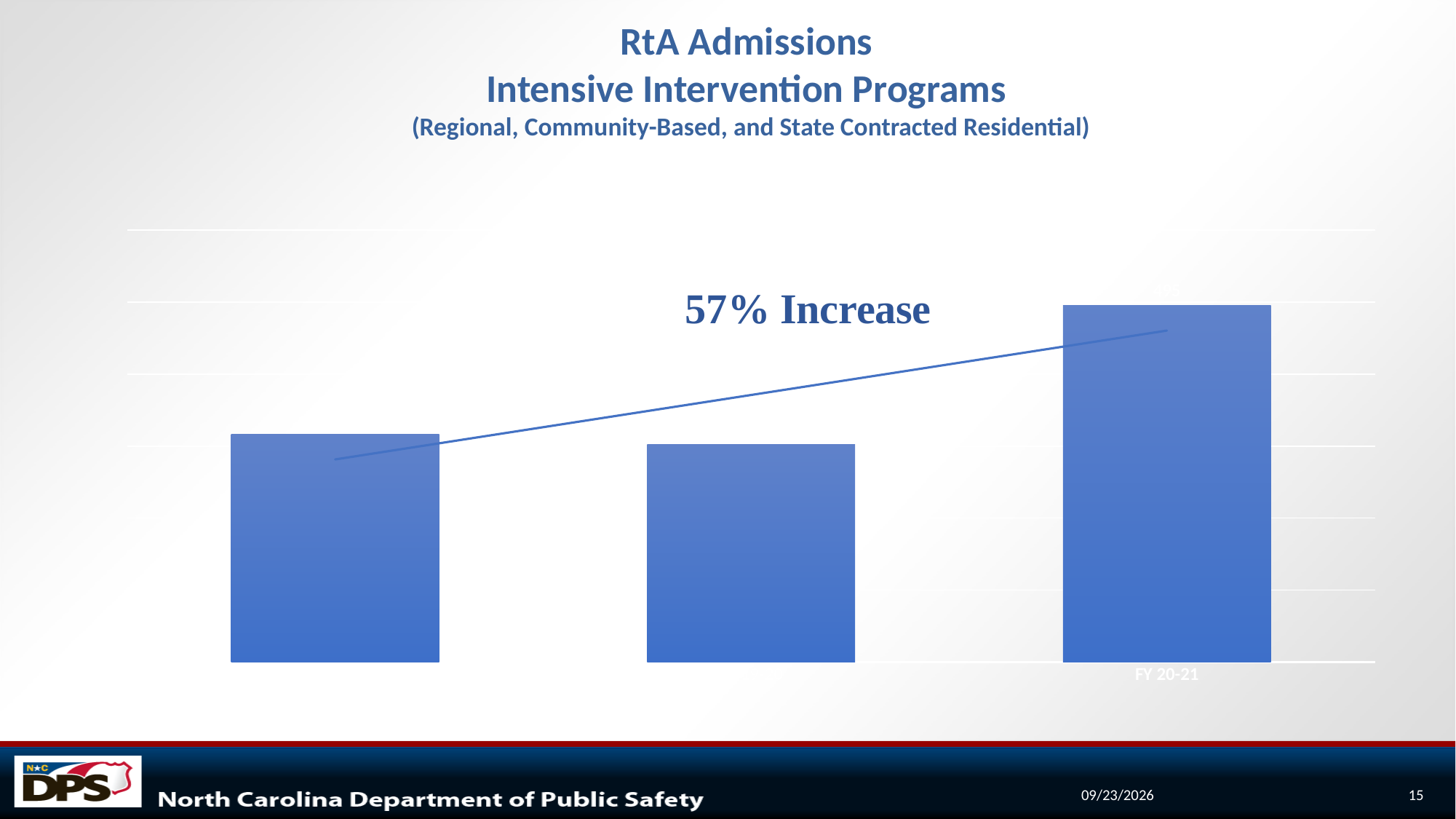
Which bar in the chart is the tallest? FY 20-21 How many bars are plotted in the chart? 3 What is the main title of the chart on the slide? RtA Admissions Intensive Intervention Programs Which is taller, the FY 20-21 bar or the middle bar? FY 20-21 Is the FY 20-21 bar higher or lower than the first (leftmost) bar? higher What kind of chart is shown on the slide? bar chart What percentage increase is annotated on the chart? 57% Increase